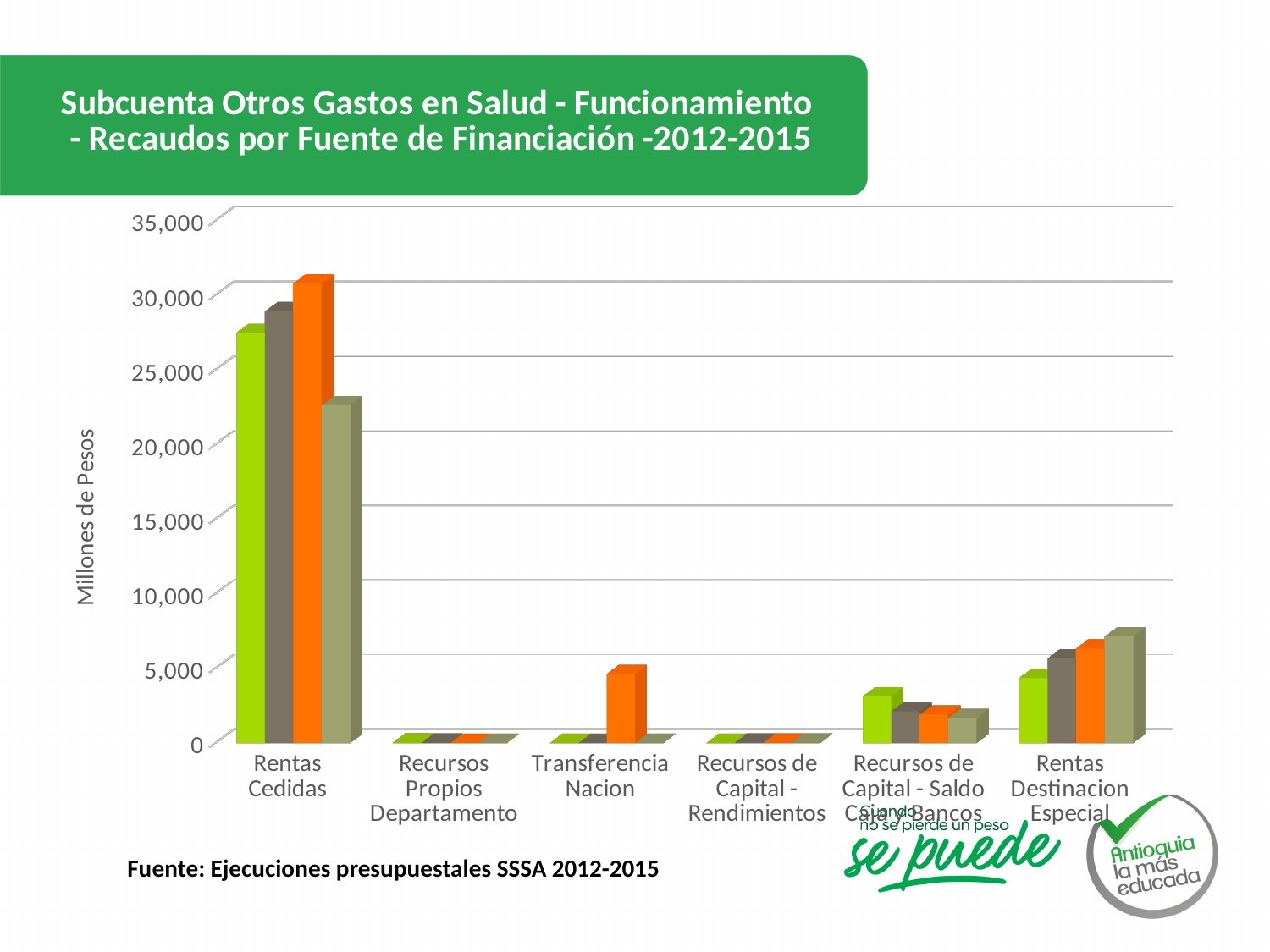
What is the label of the vertical axis of the chart? Millones de Pesos Is the value of the light green bar for Recursos de Capital - Saldo Caja y Bancos greater or less than 5,000? less How many funding source categories are shown on the x axis of the chart? 6 Which category has larger values, Rentas Destinacion Especial or Recursos de Capital - Saldo Caja y Bancos? Rentas Destinacion Especial Is the value of the olive (rightmost) bar for Rentas Destinacion Especial greater or less than 5,000? greater Which category has the highest values in the chart? Rentas Cedidas What kind of chart is shown on the slide? bar chart Is the value of the light green bar for Rentas Cedidas greater or less than 25,000? greater What source is cited below the chart? Fuente: Ejecuciones presupuestales SSSA 2012-2015